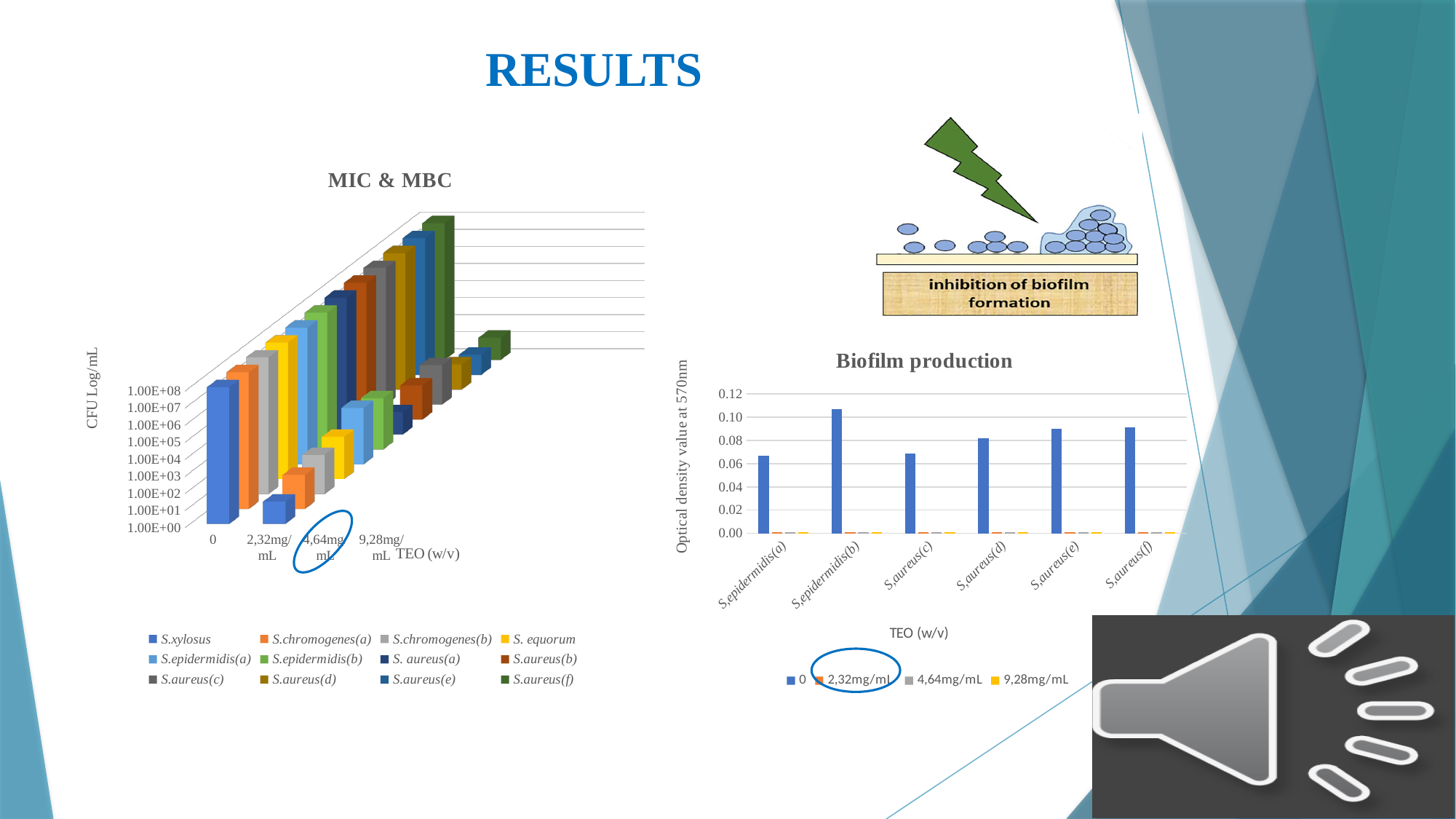
How many categories are shown on the x axis of the "Biofilm production" chart? 6 In the "Biofilm production" chart, which is larger for the 0 series: S,epidermidis(b) or S,aureus(c)? S,epidermidis(b) In the "Biofilm production" chart, is the value of the 0 series for S,aureus(c) greater or less than 0.08? less How many series does the legend of the "MIC & MBC" chart list? 12 What is the y-axis title of the "Biofilm production" chart? Optical density value at 570nm In the "Biofilm production" chart, which category has the highest value for the 0 series? S,epidermidis(b) How many TEO concentration categories are shown on the x axis of the "MIC & MBC" chart? 4 In the "Biofilm production" chart, is the value of the 0 series for S,epidermidis(b) greater or less than 0.10? greater In the "Biofilm production" chart, is the value of the 0 series for S,aureus(e) greater or less than 0.08? greater What type of chart is the "Biofilm production" chart? bar chart How many series does the legend of the "Biofilm production" chart list? 4 In the "MIC & MBC" chart, do the values for S.xylosus rise or fall as the TEO concentration increases along the x axis? fall